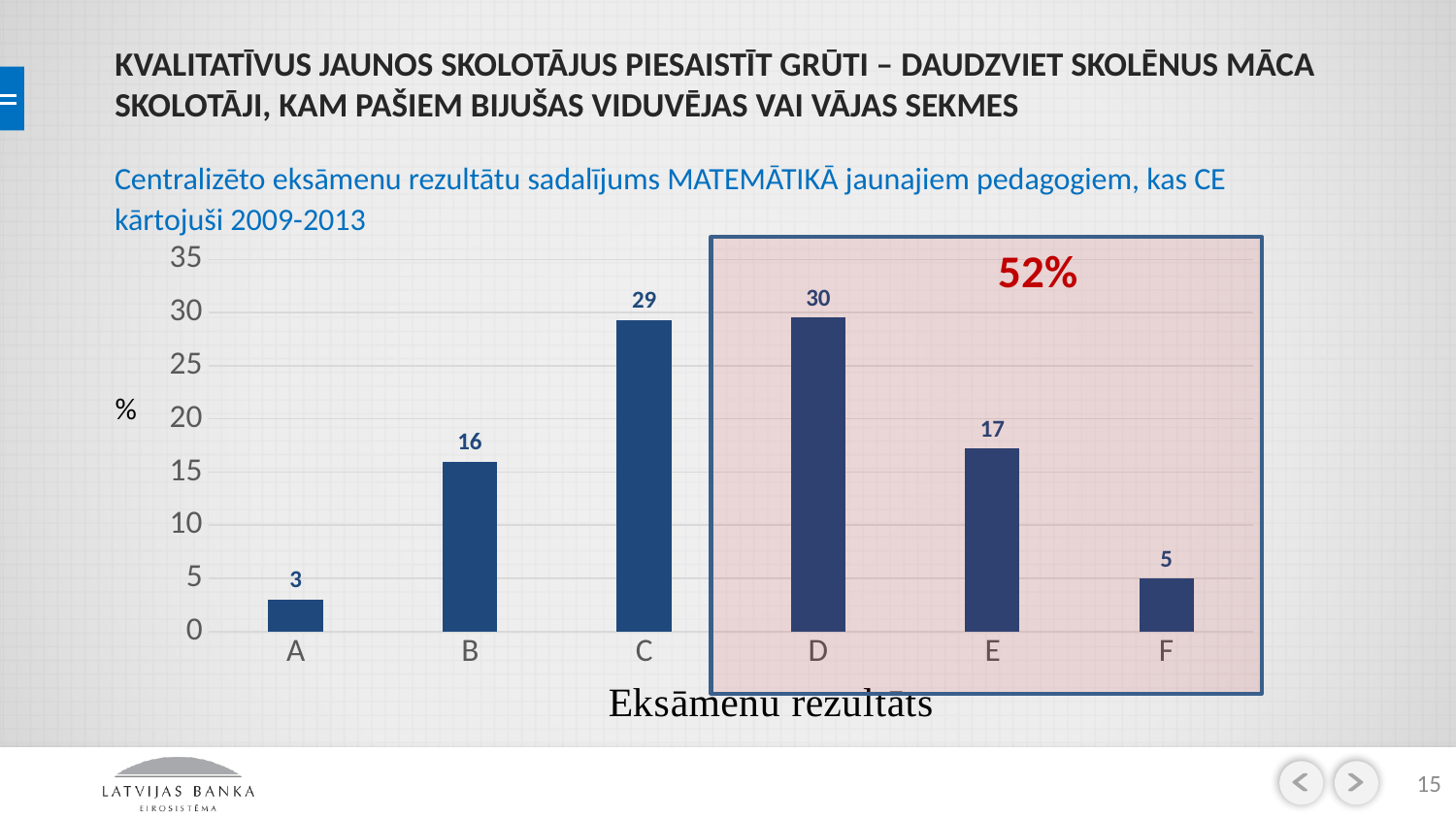
Which category has the highest value? D Which category has the lowest value? A What is the value for category E? 17 Is the value for B greater or less than 20? less How many categories are shown on the x axis? 6 Which is larger, the value for E or the value for F? E What is the value for category D? 30 What is the difference between the values for C and B? 13 What percentage is printed in red inside the highlighted box on the chart? 52% What is the total of the values for D, E and F? 52 What kind of chart is shown? bar chart What is the value for category A? 3